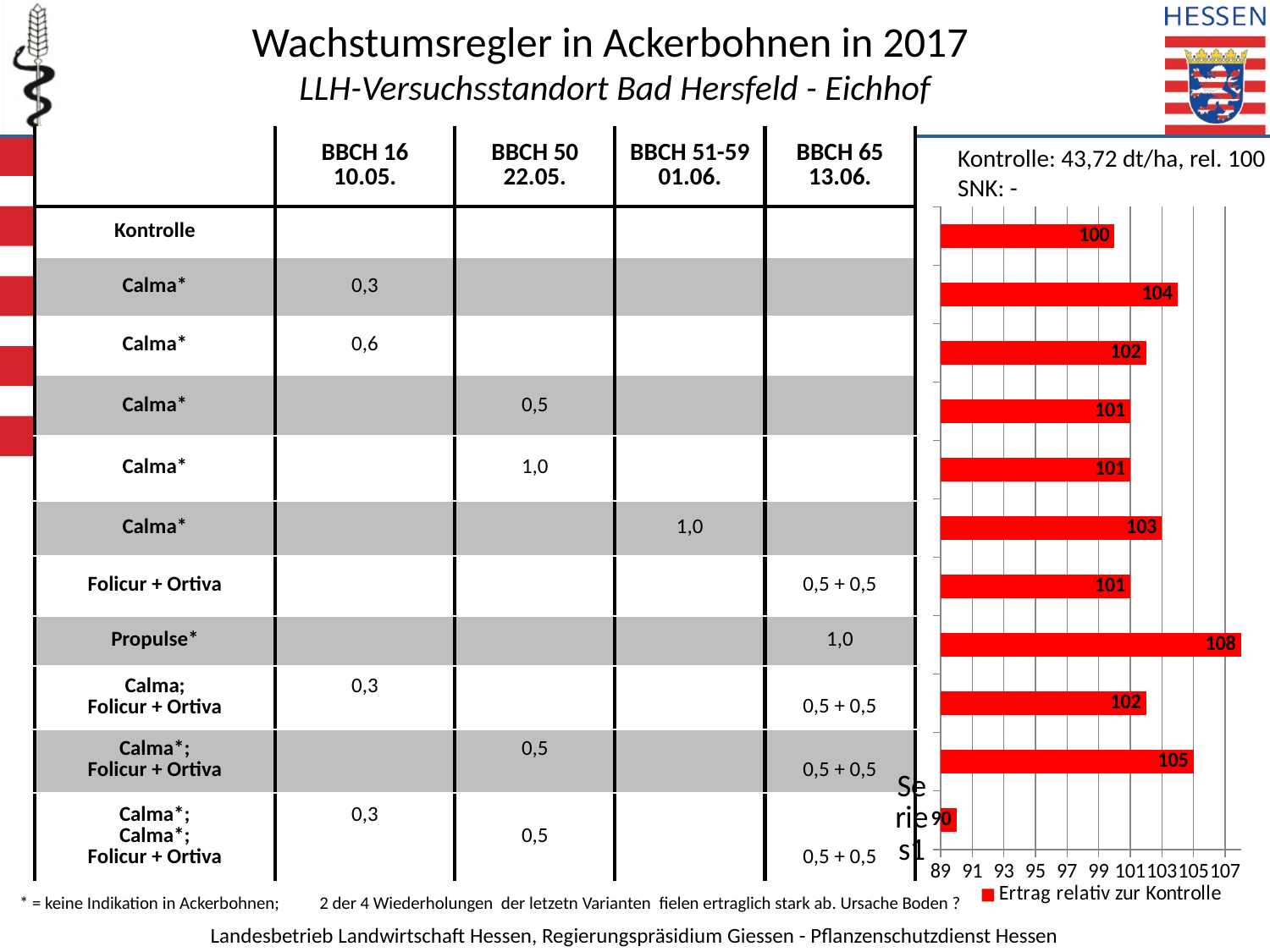
Which variant has the lowest relative yield in the chart? Calma*; Calma*; Folicur + Ortiva (bottom bar) What is the relative yield value shown for the Propulse* variant? 108 Which has the larger relative yield: Propulse* or Calma*; Folicur + Ortiva (second bar from the bottom)? Propulse* Which variant has the highest relative yield in the chart? Propulse* What is the difference between the relative yield of Propulse* and the Kontrolle? 8 What is the relative yield value shown for the bottom bar (Calma*; Calma*; Folicur + Ortiva)? 90 How many series does the chart legend list? 1 How many bars does the chart on the right contain? 11 What is the legend entry of the chart? Ertrag relativ zur Kontrolle What is the relative yield value shown for the Kontrolle (top bar)? 100 What kind of chart is shown on the right side of the slide? bar chart What is the relative yield value shown for the Folicur + Ortiva variant (seventh bar from the top)? 101